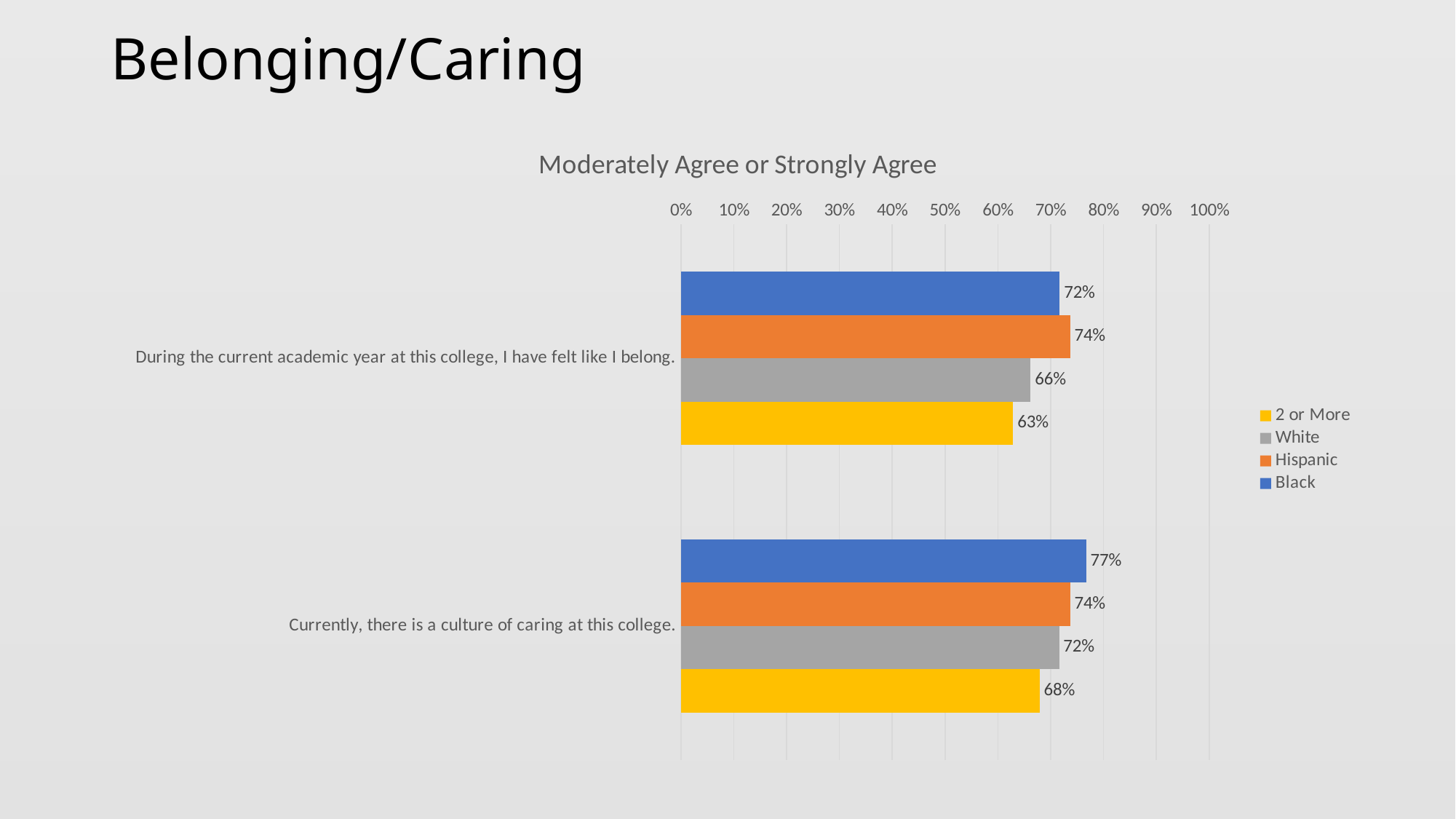
What percentage of Black students moderately or strongly agreed that they have felt like they belong during the current academic year? 72% How many series does the legend list? 4 What is the value for the '2 or More' group on the statement 'During the current academic year at this college, I have felt like I belong.'? 63% What type of chart is shown on the slide? Bar chart Which group has the lowest value for 'During the current academic year at this college, I have felt like I belong.'? 2 or More What is the difference between the Hispanic and '2 or More' values for the belonging statement? 11% What is the difference between the Black and White values for the culture of caring statement? 5% What percentage of Hispanic students agreed that there is currently a culture of caring at this college? 74% Which is larger: the Black value for the belonging statement or the Black value for the culture of caring statement? Culture of caring statement What is the value for White students on the statement 'Currently, there is a culture of caring at this college.'? 72% Which group has the highest value for 'Currently, there is a culture of caring at this college.'? Black What is the title of the chart? Moderately Agree or Strongly Agree